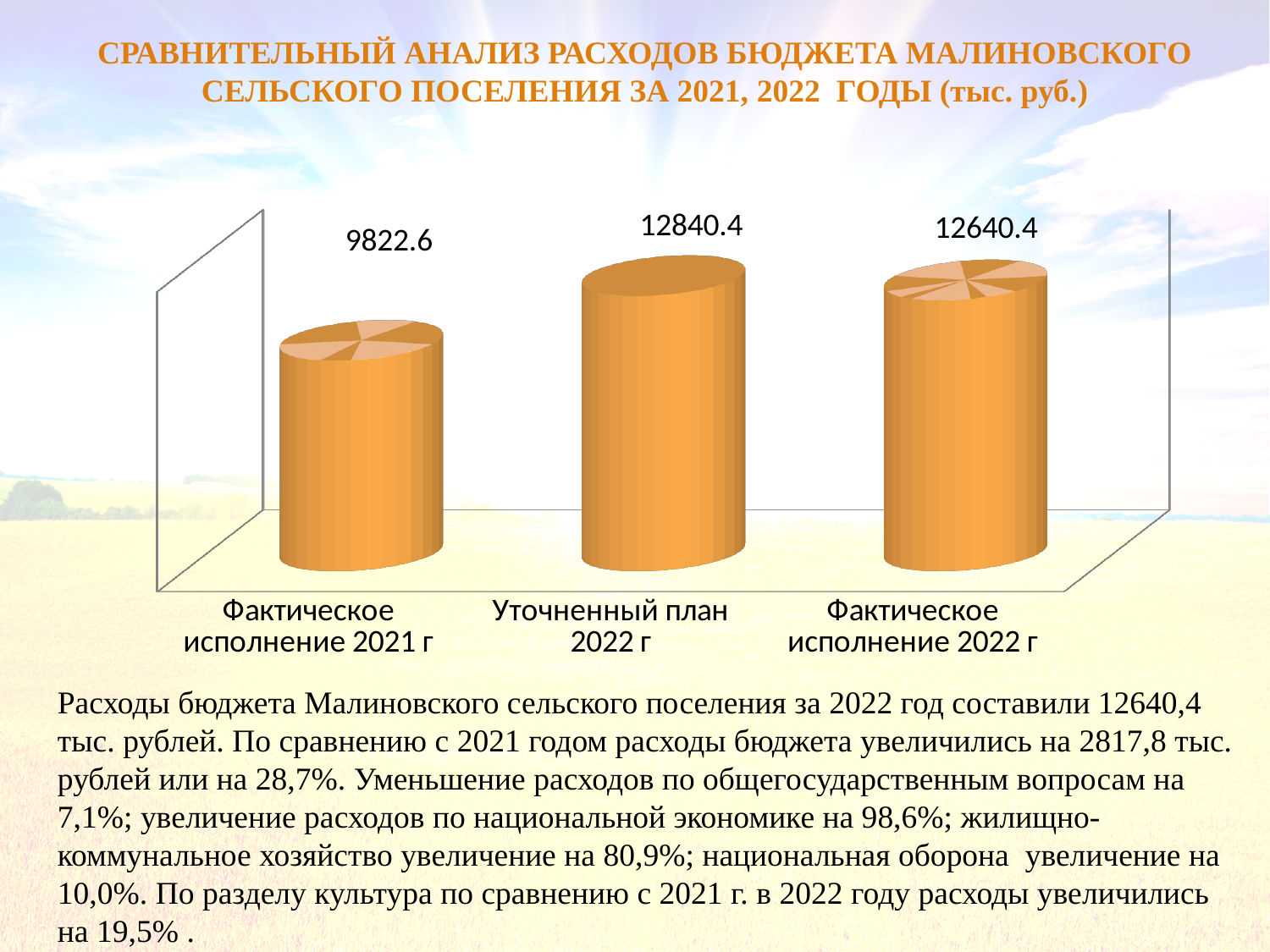
Which is larger: Уточненный план 2022 г or Фактическое исполнение 2022 г? Уточненный план 2022 г Which category has the lowest value? Фактическое исполнение 2021 г What is the difference between Уточненный план 2022 г and Фактическое исполнение 2022 г? 200 What kind of chart is shown on the slide? Bar chart What is the value shown for Фактическое исполнение 2021 г? 9822.6 What is the difference between Уточненный план 2022 г and Фактическое исполнение 2021 г? 3017.8 What is the value shown for Уточненный план 2022 г? 12840.4 What is the difference between Фактическое исполнение 2022 г and Фактическое исполнение 2021 г? 2817.8 How many categories are plotted in the chart? 3 What is the value shown for Фактическое исполнение 2022 г? 12640.4 What unit of measurement is stated in the slide title for the chart values? тыс. руб. Which category has the highest value? Уточненный план 2022 г